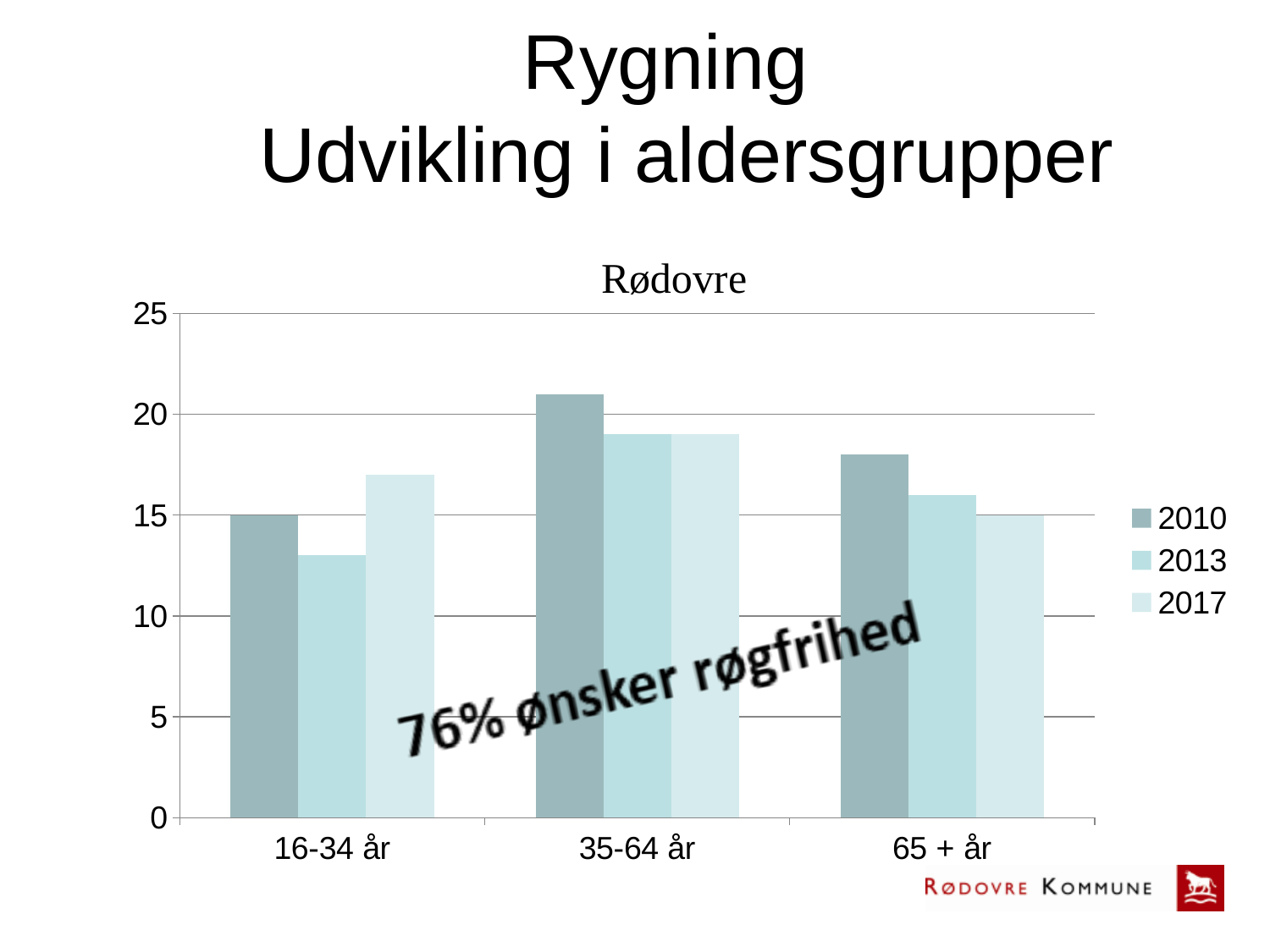
What is the value for 2010 in the 16-34 år group? 15 Is the value for 2010 in the 35-64 år group greater or less than 20? greater Is the value for 2013 in the 16-34 år group greater or less than 15? less In the 16-34 år group, which is larger, the 2013 value or the 2017 value? 2017 How many series does the chart's legend list? 3 What type of chart is shown on the slide? bar chart What is the title of the chart? Rødovre For the 65 + år group, do the values rise or fall from 2010 to 2017? fall How many age groups are shown on the x axis of the chart? 3 Which age group has the lowest 2013 value? 16-34 år What is the value for 2017 in the 65 + år group? 15 Which age group has the highest 2010 value? 35-64 år